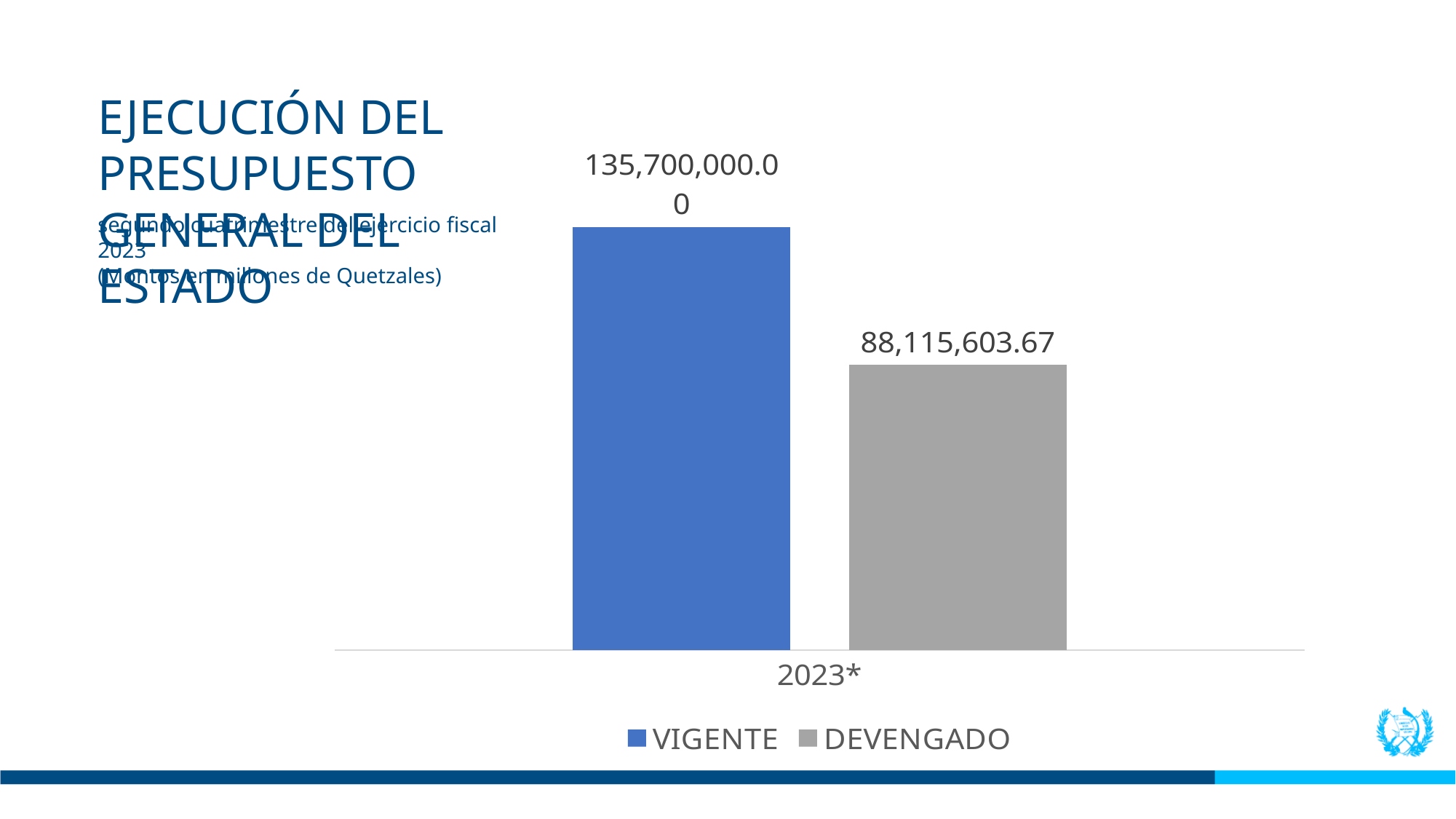
What is the difference between the VIGENTE and DEVENGADO values for 2023*? 47,584,396.33 What is the category label shown on the x axis? 2023* What kind of chart is shown on the slide? Bar chart Which series has the lowest value on the chart? DEVENGADO What is the value of the DEVENGADO bar for 2023*? 88,115,603.67 Which series has the highest value on the chart? VIGENTE How many categories are shown on the x axis? 1 How many series does the legend list? 2 What is the value of the VIGENTE bar for 2023*? 135,700,000.00 Which series has the higher value for 2023*, VIGENTE or DEVENGADO? VIGENTE Which colour represents the DEVENGADO series in the legend? Gray